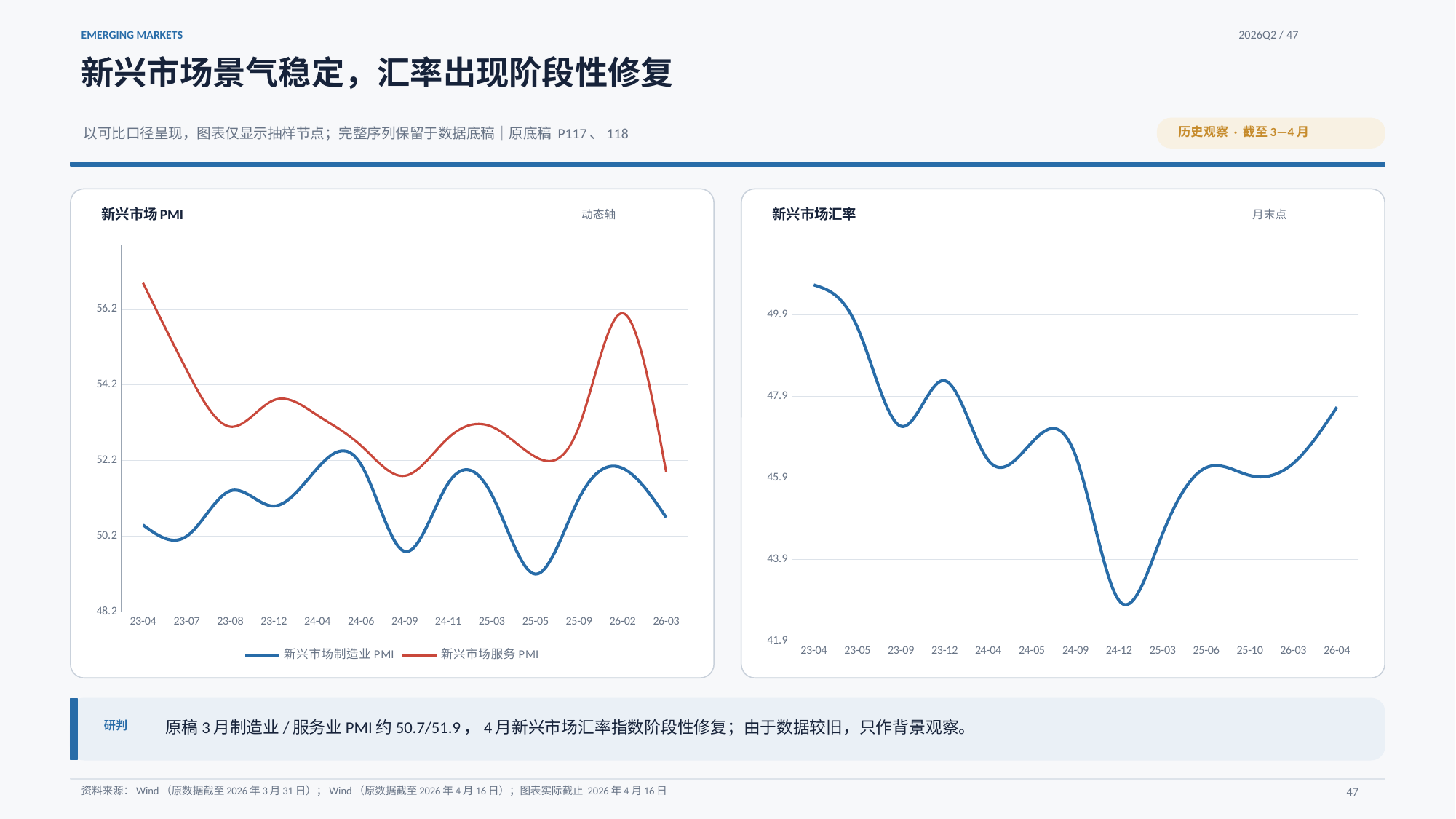
In the 新兴市场 PMI chart, is the value of 新兴市场服务 PMI at 23-04 greater or less than 56.2? greater How many series does the legend of the 新兴市场 PMI chart list? 2 In the 新兴市场汇率 chart, at which time point is the value lowest? 24-12 In the 新兴市场汇率 chart, does the value rise or fall from 24-12 to 26-04? rise What kind of chart is the 新兴市场 PMI chart on the left? line chart How many time points are shown on the x axis of the 新兴市场汇率 chart on the right? 13 In the 新兴市场 PMI chart, is the value of 新兴市场制造业 PMI at 25-05 greater or less than 50.2? less In the 新兴市场 PMI chart, at which time point is 新兴市场制造业 PMI lowest? 25-05 How many time points are shown on the x axis of the 新兴市场 PMI chart? 13 In the 新兴市场汇率 chart, at which time point is the value highest? 23-04 In the 新兴市场 PMI chart, which series is higher at 23-04, 新兴市场制造业 PMI or 新兴市场服务 PMI? 新兴市场服务 PMI In the 新兴市场 PMI chart, which colour is used for the 新兴市场服务 PMI line? red